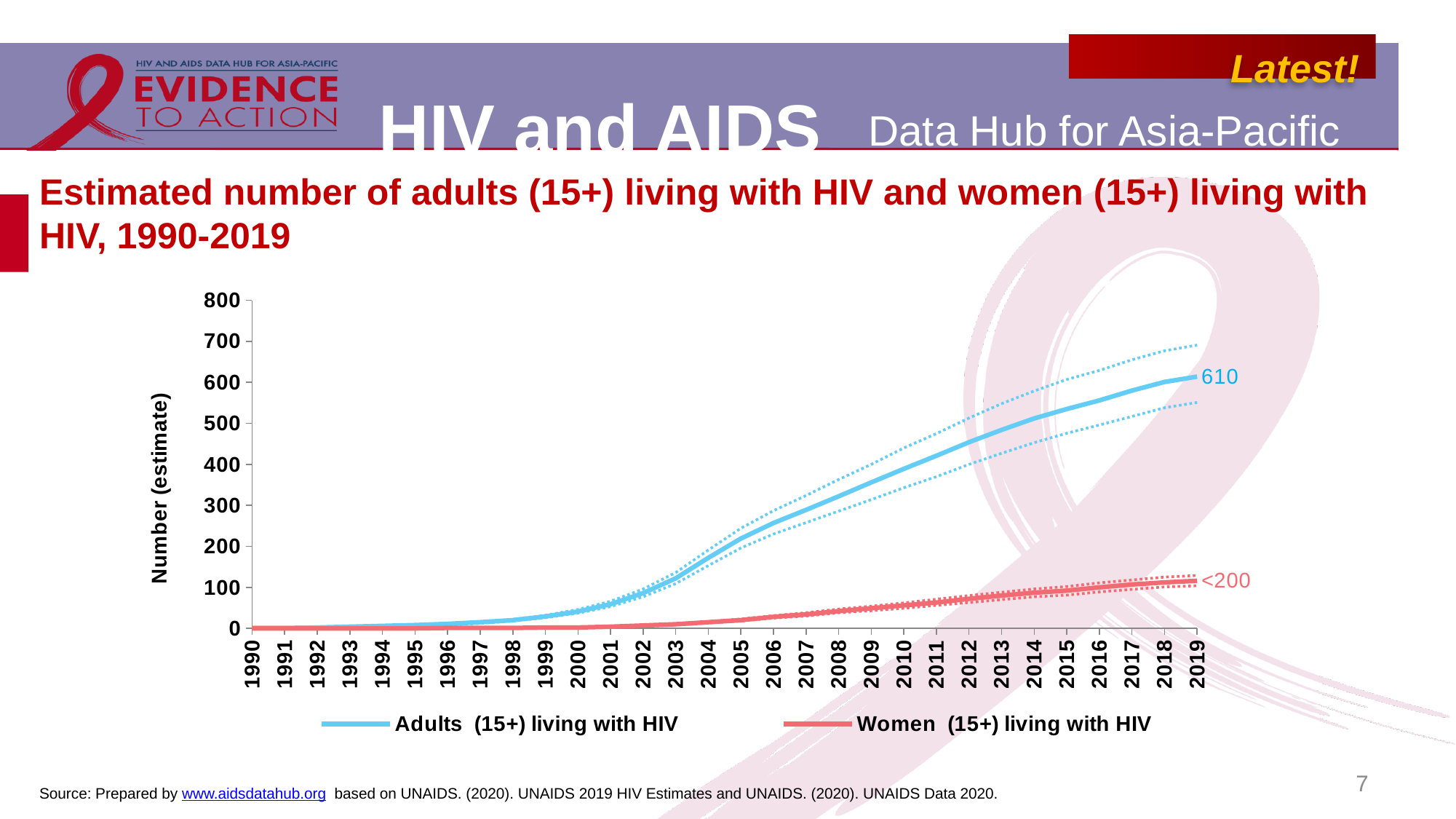
In which year is the number of adults (15+) living with HIV highest? 2019 Is the value for adults (15+) living with HIV in 2010 greater or less than 300? greater What is the estimated number of adults (15+) living with HIV in 2019? 610 Does the number of adults (15+) living with HIV rise or fall from 1990 to 2019? Rise What is the data label shown for women (15+) living with HIV in 2019? <200 In 2019, which is larger: the number of adults (15+) living with HIV or the number of women (15+) living with HIV? Adults (15+) living with HIV Is the value for women (15+) living with HIV in 2010 greater or less than 100? less Which colour represents women (15+) living with HIV in the chart? Red How many years are shown along the x axis? 30 What kind of chart is shown on the slide? Line chart How many series does the legend list? 2 Is the value for adults (15+) living with HIV in 2005 greater or less than 300? less